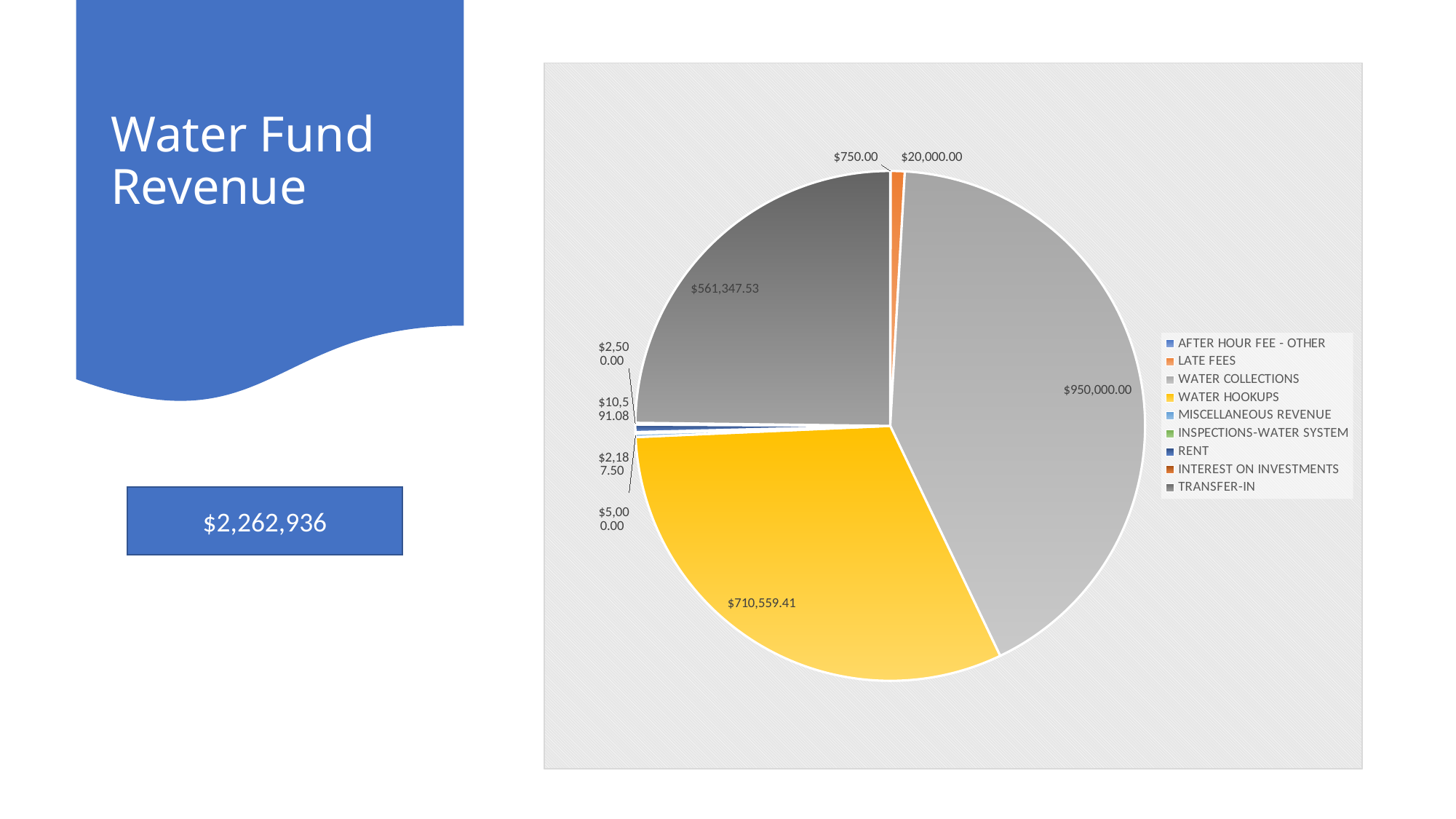
What type of chart is shown on the slide? Pie chart What is the value for WATER COLLECTIONS? $950,000.00 What is the value for WATER HOOKUPS? $710,559.41 What is the value for LATE FEES? $20,000.00 How many categories does the legend list? 9 What is the difference between LATE FEES and AFTER HOUR FEE - OTHER? $19,250.00 Which category has the largest slice of the pie? WATER COLLECTIONS What is the value for AFTER HOUR FEE - OTHER? $750.00 Which is larger, WATER HOOKUPS or TRANSFER-IN? WATER HOOKUPS What is the value for TRANSFER-IN? $561,347.53 What colour is the WATER HOOKUPS slice? Yellow What is the difference between WATER COLLECTIONS and WATER HOOKUPS? $239,440.59